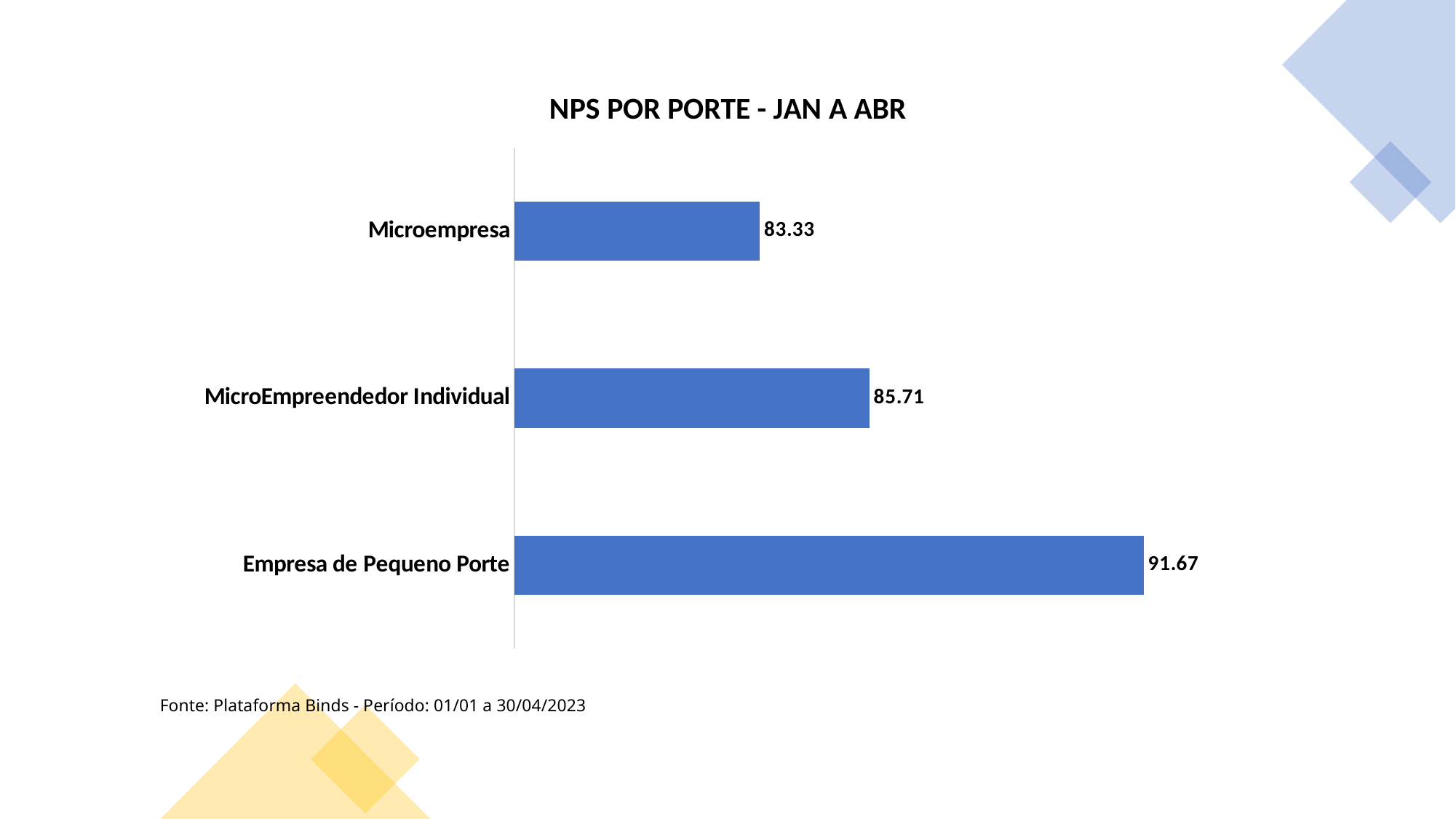
Which category has the lowest NPS? Microempresa What is the difference between the NPS of Empresa de Pequeno Porte and Microempresa? 8.34 What is the NPS value for MicroEmpreendedor Individual? 85.71 What is the NPS value for Empresa de Pequeno Porte? 91.67 Which has a higher NPS, Microempresa or MicroEmpreendedor Individual? MicroEmpreendedor Individual How many categories are shown in the chart? 3 What is the NPS value for Microempresa? 83.33 What kind of chart is shown on the slide? Bar chart What is the difference between the NPS of MicroEmpreendedor Individual and Microempresa? 2.38 What is the title of the chart? NPS POR PORTE - JAN A ABR What is the source cited below the chart? Plataforma Binds - Período: 01/01 a 30/04/2023 Which category has the highest NPS? Empresa de Pequeno Porte